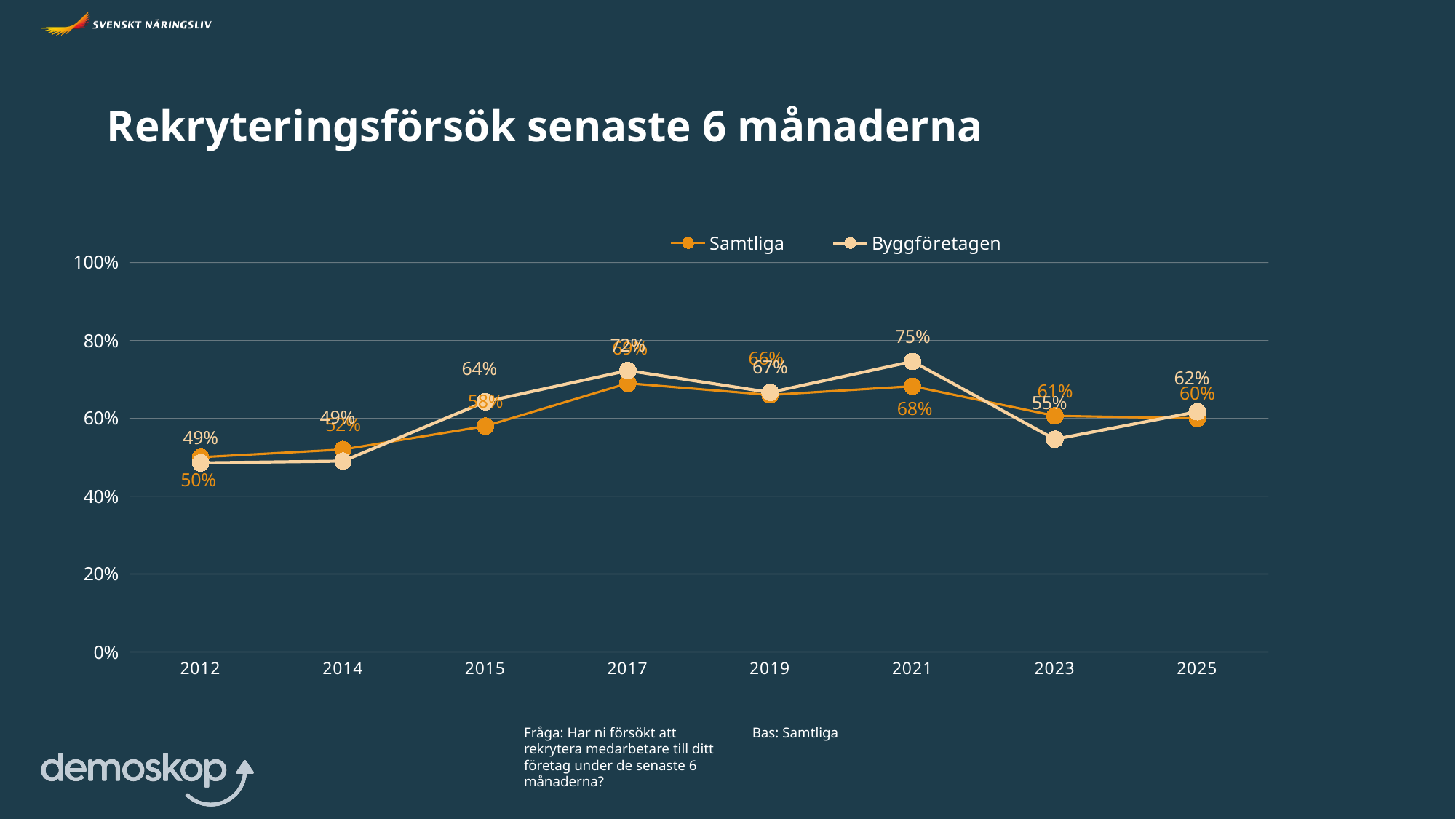
In which year does Samtliga have its lowest value? 2012 What is the value for Byggföretagen in 2015? 64% What is the value for Samtliga in 2023? 61% In which year does Byggföretagen reach its highest value? 2021 How many years are plotted along the x axis? 8 What type of chart is shown on the slide? Line chart In 2023, which series has the higher value, Samtliga or Byggföretagen? Samtliga How many series does the legend list? 2 Does the value for Byggföretagen fall or rise from 2021 to 2023? Fall What is the difference between Byggföretagen and Samtliga in 2021? 7 percentage points What is the title of the chart? Rekryteringsförsök senaste 6 månaderna What is the value for Byggföretagen in 2021? 75%